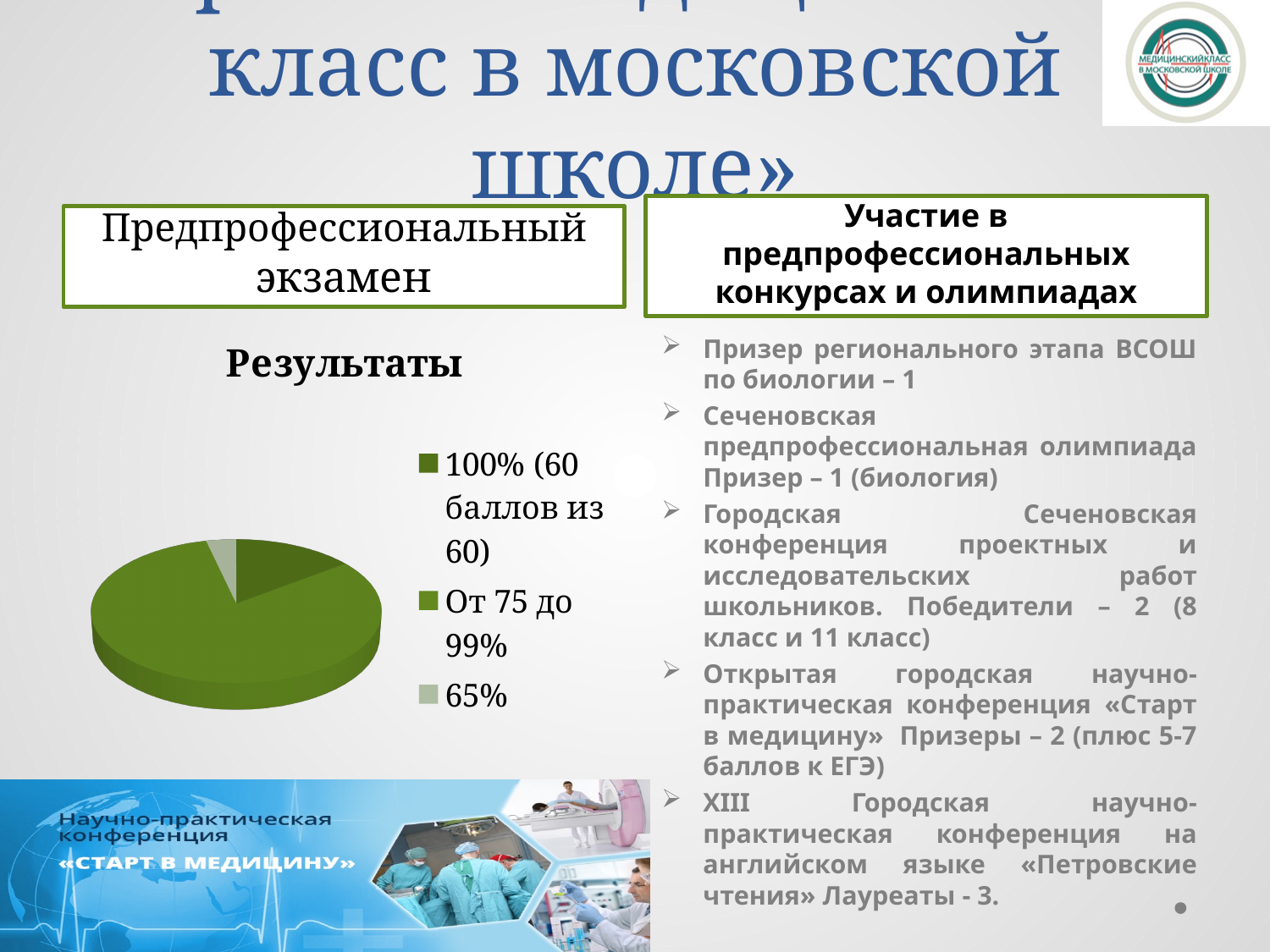
Which category has the largest slice in the pie chart? От 75 до 99% What kind of chart is shown under the heading "Результаты"? pie chart Which slice is larger in the pie chart: "От 75 до 99%" or "100% (60 баллов из 60)"? От 75 до 99% How many categories does the legend of the pie chart list? 3 What is the title of the pie chart on the slide? Результаты What is the first legend entry of the pie chart? 100% (60 баллов из 60) Which slice is larger in the pie chart: "100% (60 баллов из 60)" or "65%"? 100% (60 баллов из 60) Does the largest slice of the pie chart take up more or less than half of the pie? more